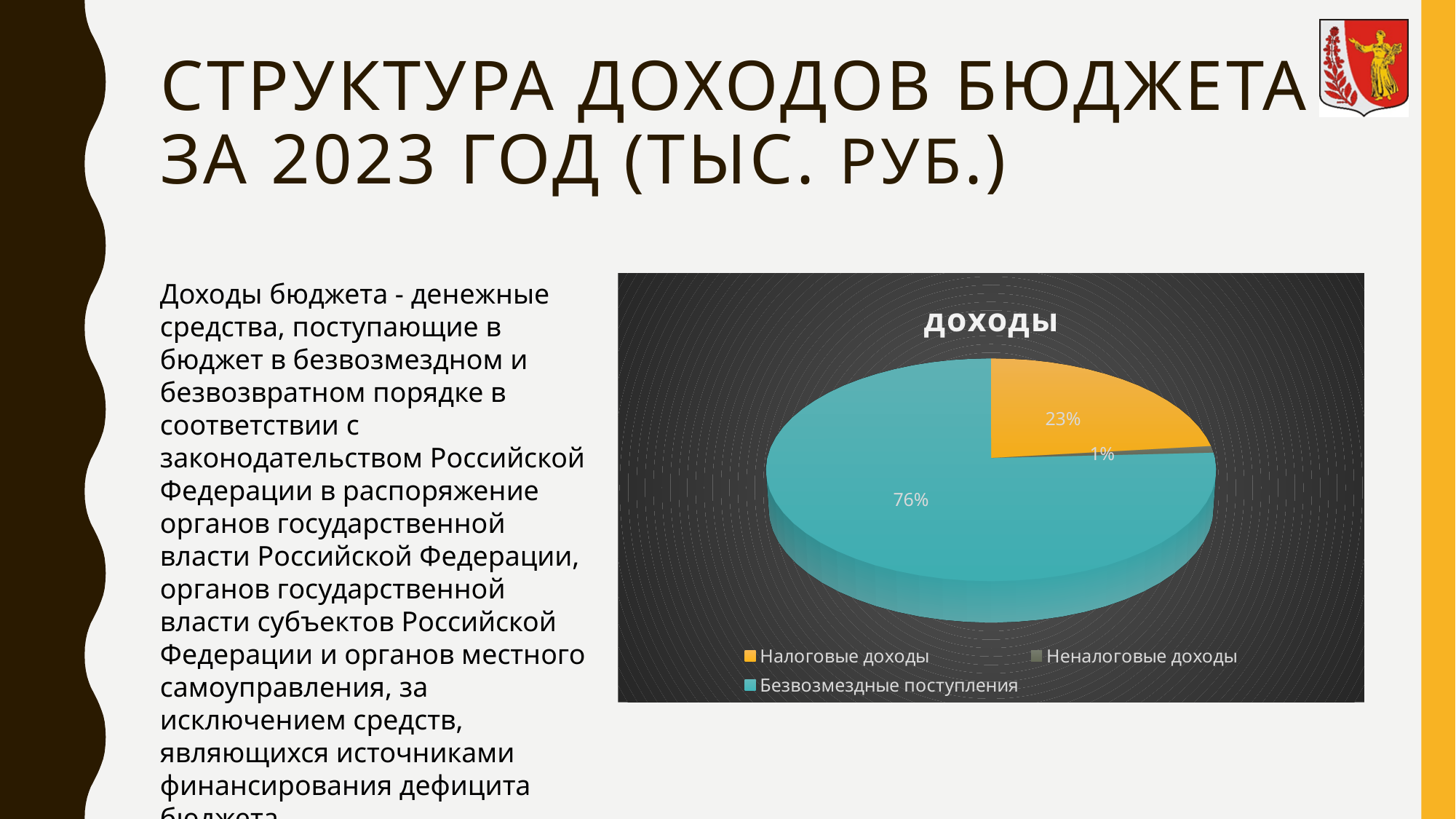
What type of chart is shown on the slide? Pie chart How many categories does the legend list? 3 Which category has the smallest slice of the pie? Неналоговые доходы What share of the pie does Налоговые доходы take? 23% What share of the pie does Безвозмездные поступления take? 76% What colour is the slice for Налоговые доходы? Orange What is the difference in percentage points between Безвозмездные поступления and Налоговые доходы? 53 What is the title of the chart? доходы What is the difference in percentage points between Налоговые доходы and Неналоговые доходы? 22 Which category has the largest slice of the pie? Безвозмездные поступления Which is larger: the share for Налоговые доходы or the share for Неналоговые доходы? Налоговые доходы What share of the pie does Неналоговые доходы take? 1%